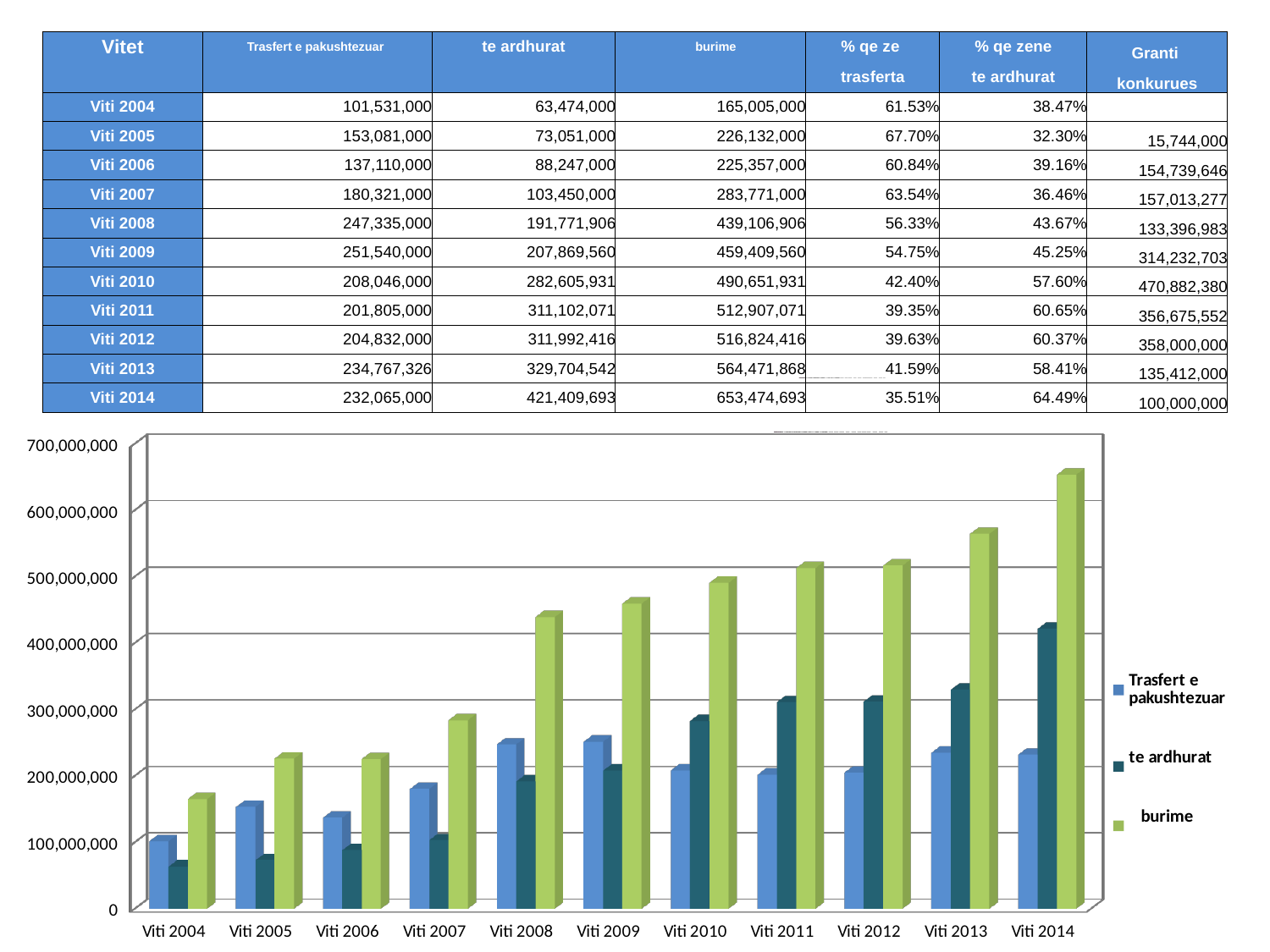
According to the table on the slide, what is the 'burime' value for Viti 2014? 653,474,693 How many years (categories) are shown along the x axis of the chart? 11 In which year is the 'burime' bar the lowest? Viti 2004 In which year is the 'burime' bar the highest? Viti 2014 Using the table values, what is the difference between 'te ardhurat' and 'Trasfert e pakushtezuar' for Viti 2014? 189,344,693 How many series does the chart's legend list? 3 What colour are the 'burime' bars in the chart? green Is the 'burime' bar for Viti 2014 greater or less than 600,000,000? greater For Viti 2010, which is larger: 'Trasfert e pakushtezuar' or 'te ardhurat'? te ardhurat Do the 'burime' values generally rise or fall from Viti 2004 to Viti 2014? rise Is the 'te ardhurat' bar for Viti 2004 greater or less than 100,000,000? less What kind of chart is shown on the slide? bar chart